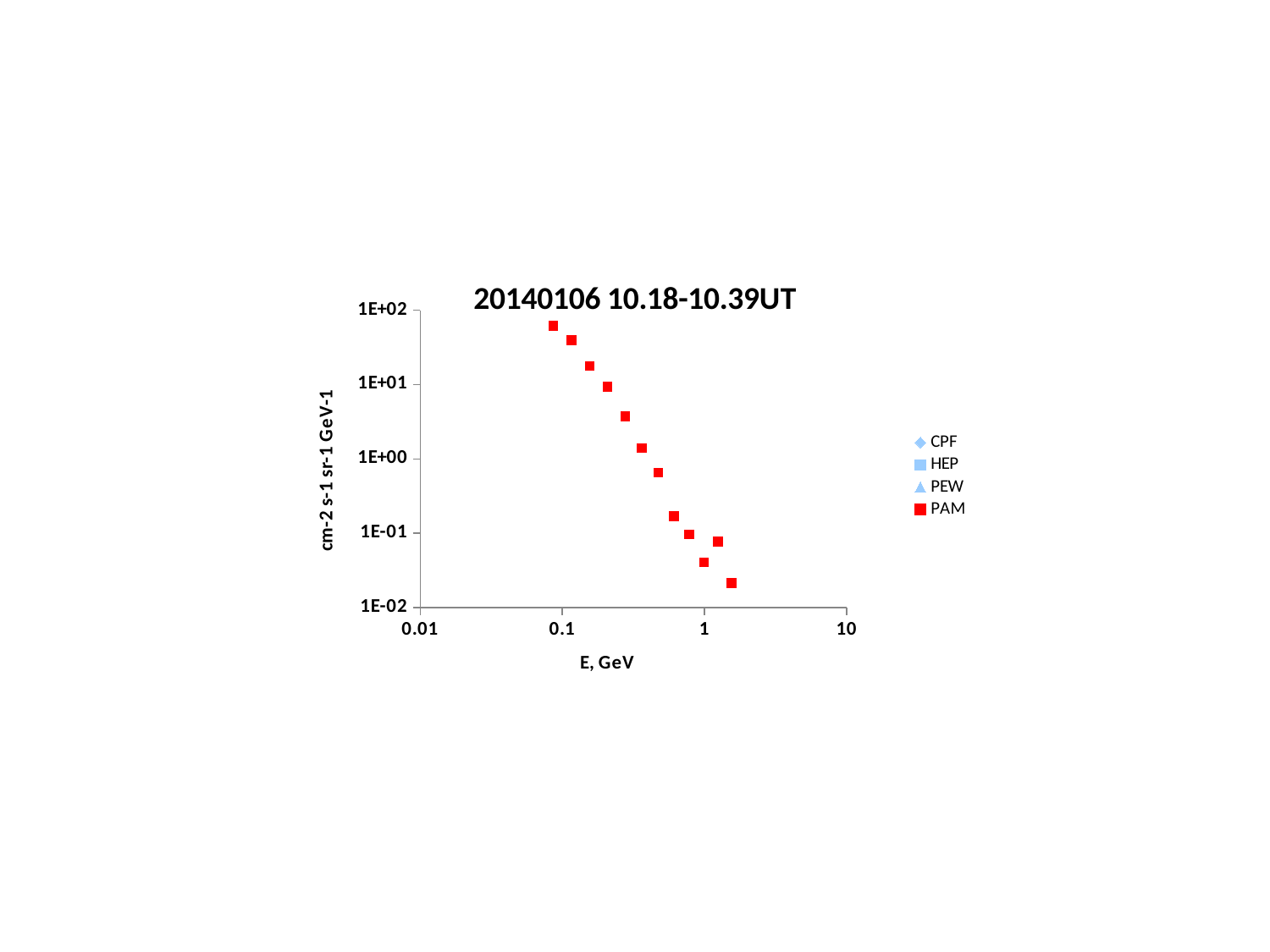
Is the value of the leftmost PAM point greater or less than 1E+01? greater Is the value of the leftmost PAM point greater or less than 1E+02? less How many series does the legend list? 4 How many PAM data points are plotted on the chart? 12 Is the PAM value at E = 1 GeV greater or less than 1E-01? less Which of the legend series has data points visible on the chart? PAM What kind of chart is shown on the slide? scatter chart Which series is plotted with red square markers? PAM What is the title of the chart? 20140106 10.18-10.39UT Do the PAM values rise or fall as E increases along the x axis? fall Which PAM point has the highest value, the leftmost or the rightmost? leftmost